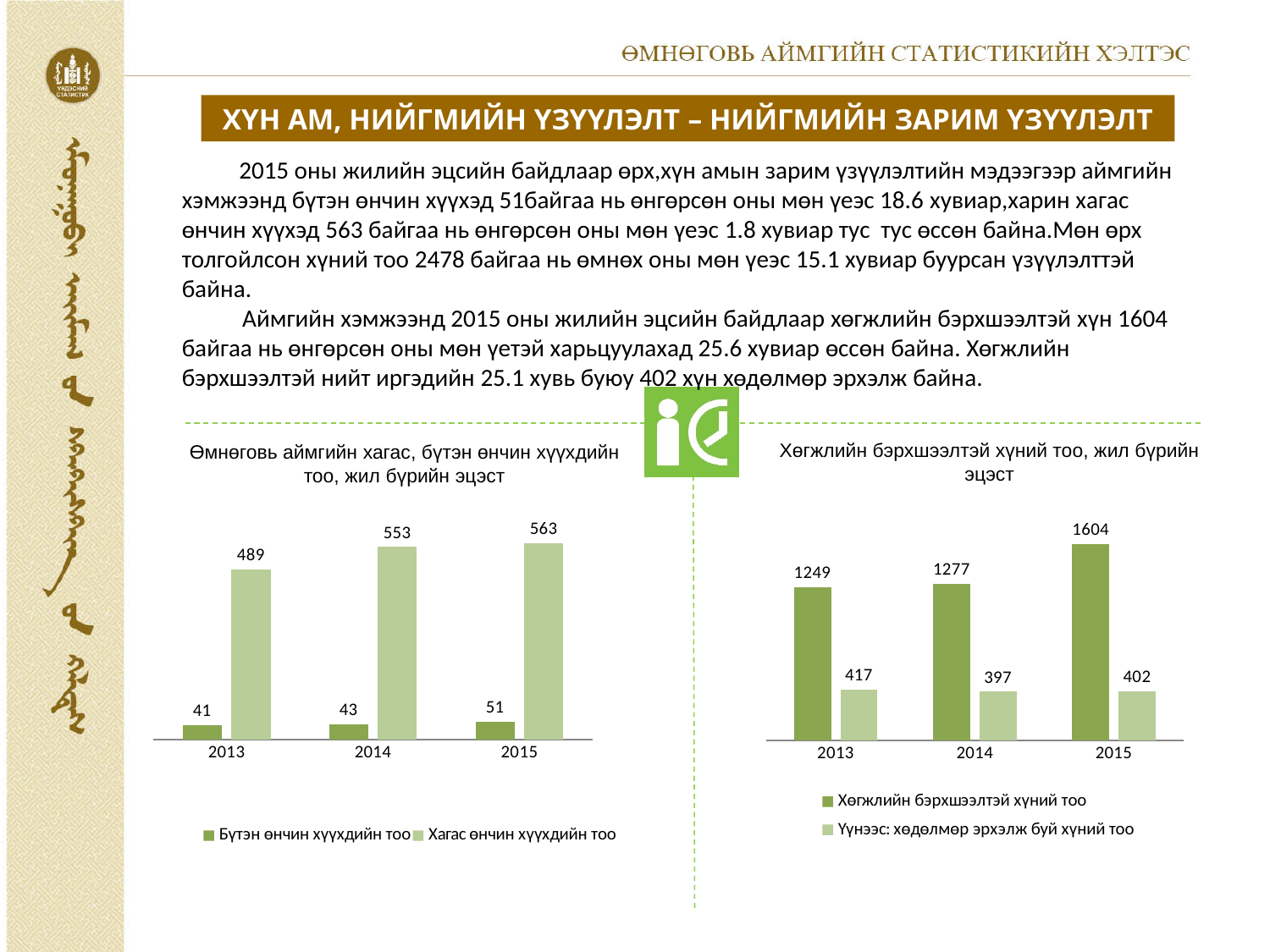
In the right chart (Хөгжлийн бэрхшээлтэй хүний тоо), what is the value for Хөгжлийн бэрхшээлтэй хүний тоо in 2015? 1604 What type of chart is the right chart (Хөгжлийн бэрхшээлтэй хүний тоо)? bar chart In the left chart (Өмнөговь аймгийн хагас, бүтэн өнчин хүүхдийн тоо), what is the value for Хагас өнчин хүүхдийн тоо in 2014? 553 In the right chart (Хөгжлийн бэрхшээлтэй хүний тоо), what is the difference between the Хөгжлийн бэрхшээлтэй хүний тоо values for 2015 and 2014? 327 In the left chart (Өмнөговь аймгийн хагас, бүтэн өнчин хүүхдийн тоо), what is the value for Бүтэн өнчин хүүхдийн тоо in 2015? 51 In the left chart (Өмнөговь аймгийн хагас, бүтэн өнчин хүүхдийн тоо), what is the difference between the Хагас өнчин хүүхдийн тоо values for 2015 and 2013? 74 In the left chart (Өмнөговь аймгийн хагас, бүтэн өнчин хүүхдийн тоо), which year has the lowest value for Бүтэн өнчин хүүхдийн тоо? 2013 In the right chart (Хөгжлийн бэрхшээлтэй хүний тоо), which is larger: Үүнээс: хөдөлмөр эрхэлж буй хүний тоо in 2013 or in 2015? 2013 In the right chart (Хөгжлийн бэрхшээлтэй хүний тоо), what is the value for Үүнээс: хөдөлмөр эрхэлж буй хүний тоо in 2014? 397 In the right chart (Хөгжлийн бэрхшээлтэй хүний тоо), which year has the highest value for Хөгжлийн бэрхшээлтэй хүний тоо? 2015 In the left chart (Өмнөговь аймгийн хагас, бүтэн өнчин хүүхдийн тоо), does the Хагас өнчин хүүхдийн тоо series rise or fall from 2013 to 2015? rise In the left chart (Өмнөговь аймгийн хагас, бүтэн өнчин хүүхдийн тоо), how many series does the legend list? 2